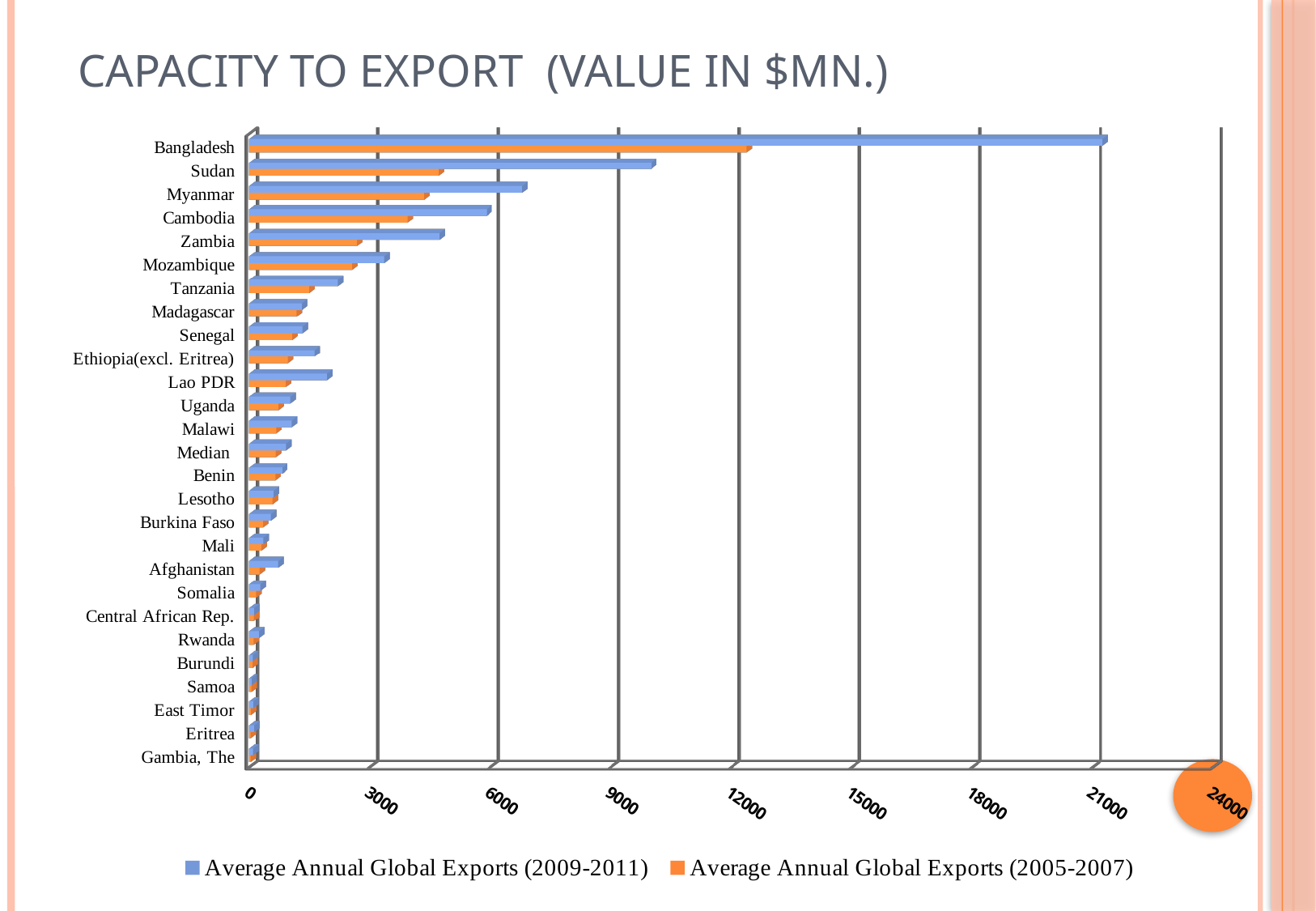
Is the value for Sudan in Average Annual Global Exports (2009-2011) greater or less than 9000? greater How many categories are plotted on the chart? 27 What kind of chart is shown on the slide? bar chart Which category has the highest value for Average Annual Global Exports (2009-2011)? Bangladesh Which category has the highest value for Average Annual Global Exports (2005-2007)? Bangladesh Is the value for Zambia in Average Annual Global Exports (2009-2011) greater or less than 6000? less Is the value for Tanzania in Average Annual Global Exports (2009-2011) greater or less than 3000? less How many series does the legend list? 2 Which colour represents Average Annual Global Exports (2005-2007) in the legend? orange Which is larger for Sudan: Average Annual Global Exports (2009-2011) or Average Annual Global Exports (2005-2007)? Average Annual Global Exports (2009-2011) What is the title of the chart? CAPACITY TO EXPORT (VALUE IN $MN.)